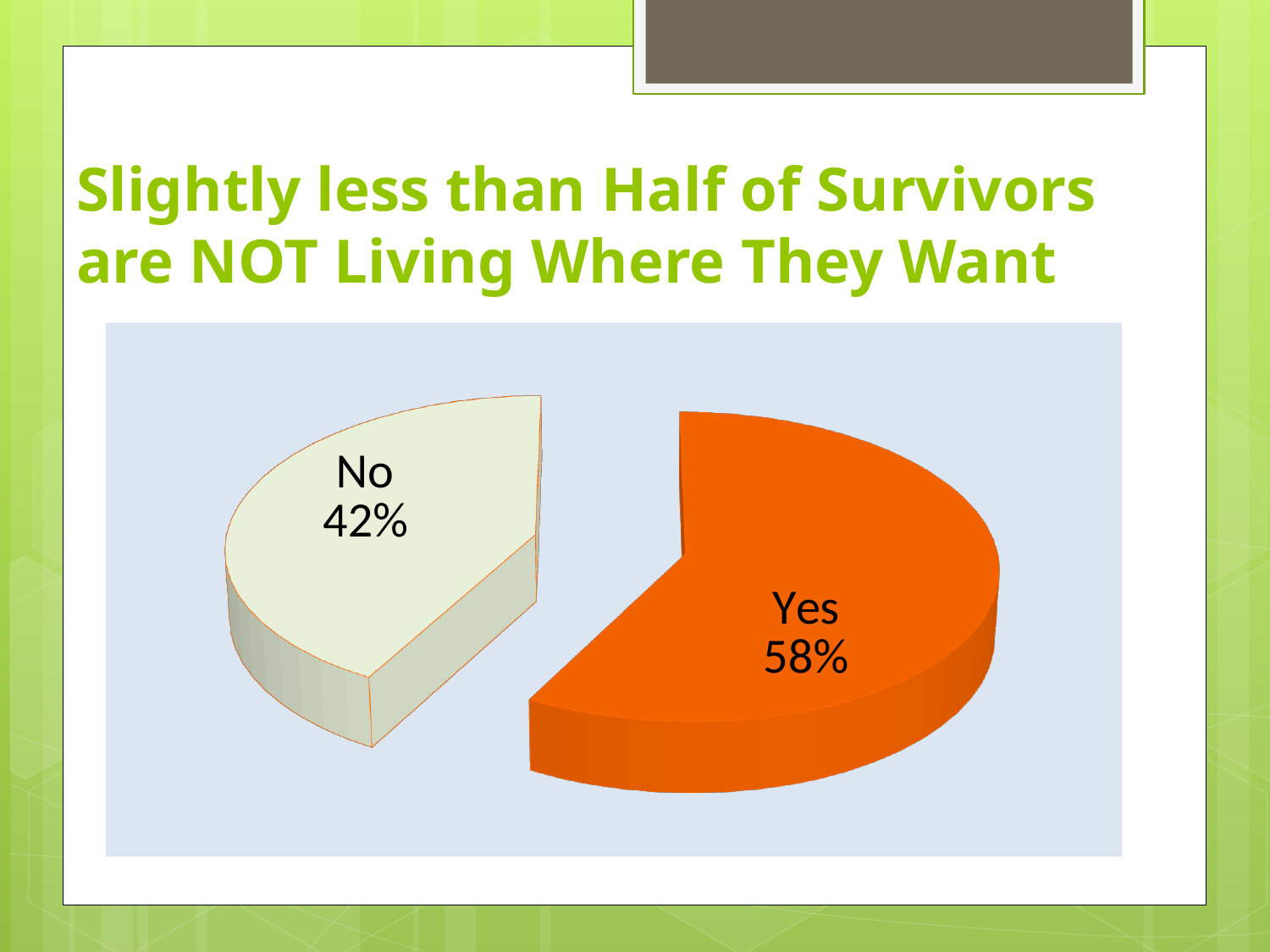
What kind of chart is shown on the slide? Pie chart What percentage of the pie is labelled "Yes"? 58% Which slice of the pie is the smallest? No What colour is the "Yes" slice? Orange What is the difference in percentage points between the "Yes" and "No" slices? 16 What share of the pie does the "No" slice represent? 42% Which slice is larger, "Yes" or "No"? Yes Which slice of the pie is the largest? Yes How many slices does the pie chart have? 2 What percentage of the pie is labelled "No"? 42% What is the title of the slide containing the pie chart? Slightly less than Half of Survivors are NOT Living Where They Want